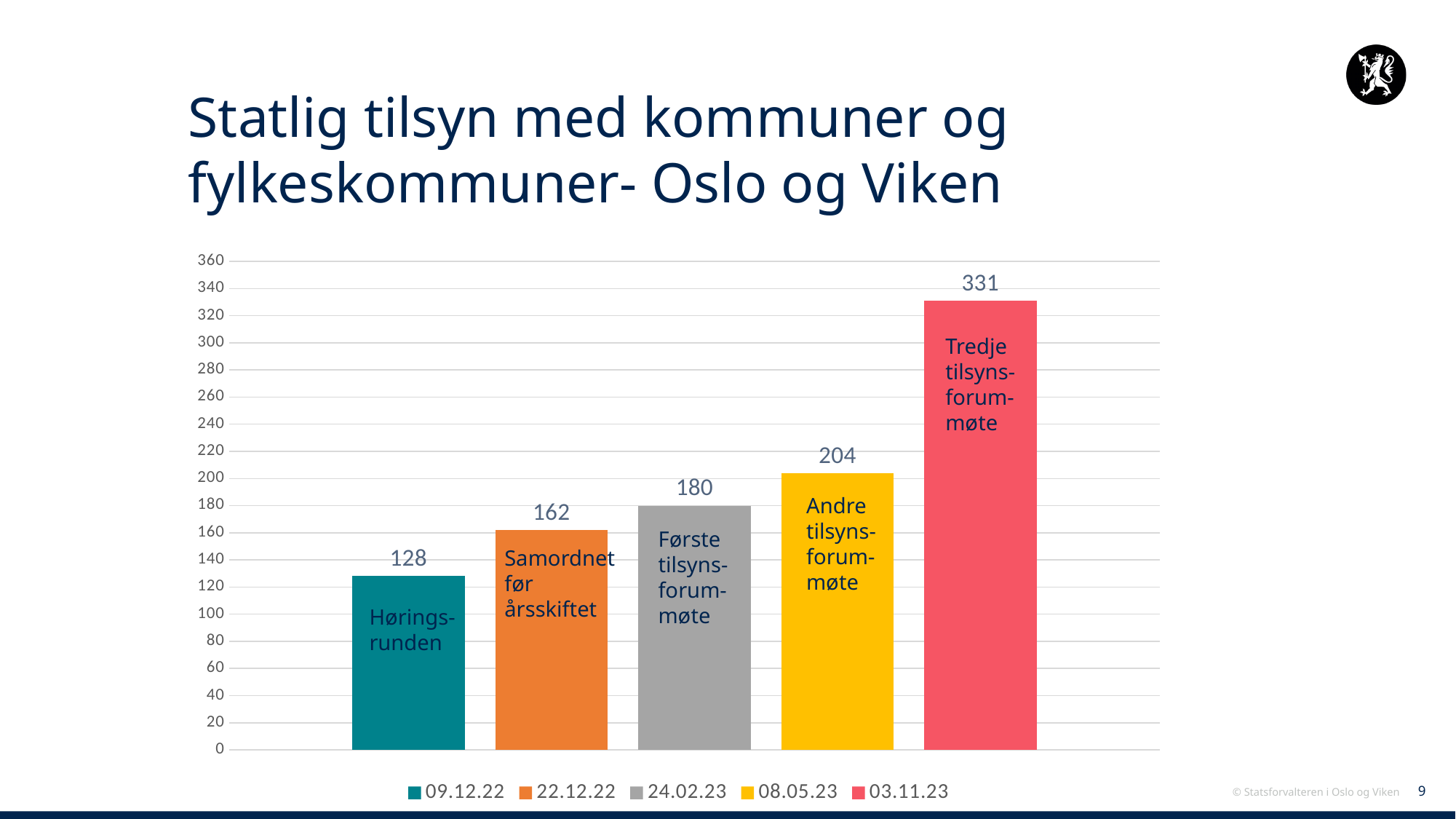
Which date has the lowest value? 09.12.22 What is the value for the bar labelled 09.12.22 (Høringsrunden)? 128 How many bars are shown in the chart? 5 What kind of chart is shown on the slide? Bar chart What is the value for the bar labelled 22.12.22 (Samordnet før årsskiftet)? 162 What is the difference between the values for 03.11.23 and 08.05.23? 127 Do the values rise or fall from left to right across the bars? Rise What is the value for the bar labelled 03.11.23 (Tredje tilsynsforummøte)? 331 Which date has the highest value? 03.11.23 How many entries does the legend list? 5 Which is larger, the value for 08.05.23 or the value for 24.02.23? 08.05.23 What is the difference between the values for 24.02.23 and 09.12.22? 52